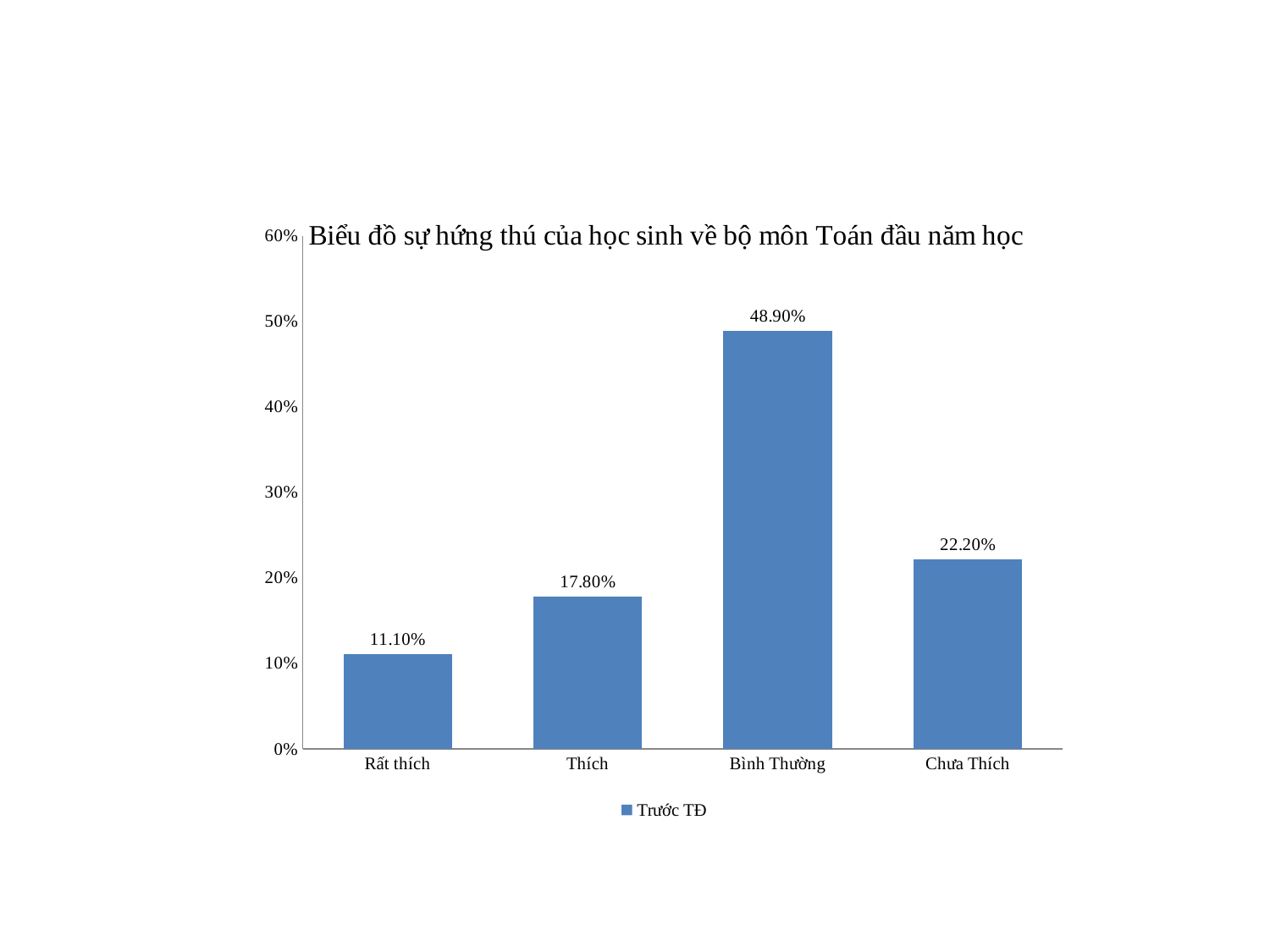
What kind of chart is shown on the slide? bar chart How many categories are shown on the x axis? 4 What is the difference between the values for Thích and Rất thích? 6.70% What is the difference between the values for Bình Thường and Chưa Thích? 26.70% Is the value for Bình Thường greater or less than 40%? greater What series name does the legend show? Trước TĐ Which is larger, the value for Thích or the value for Chưa Thích? Chưa Thích Which category has the highest value? Bình Thường What is the value for Chưa Thích? 22.20% What is the value for Rất thích? 11.10% Which category has the lowest value? Rất thích What is the value for Bình Thường? 48.90%